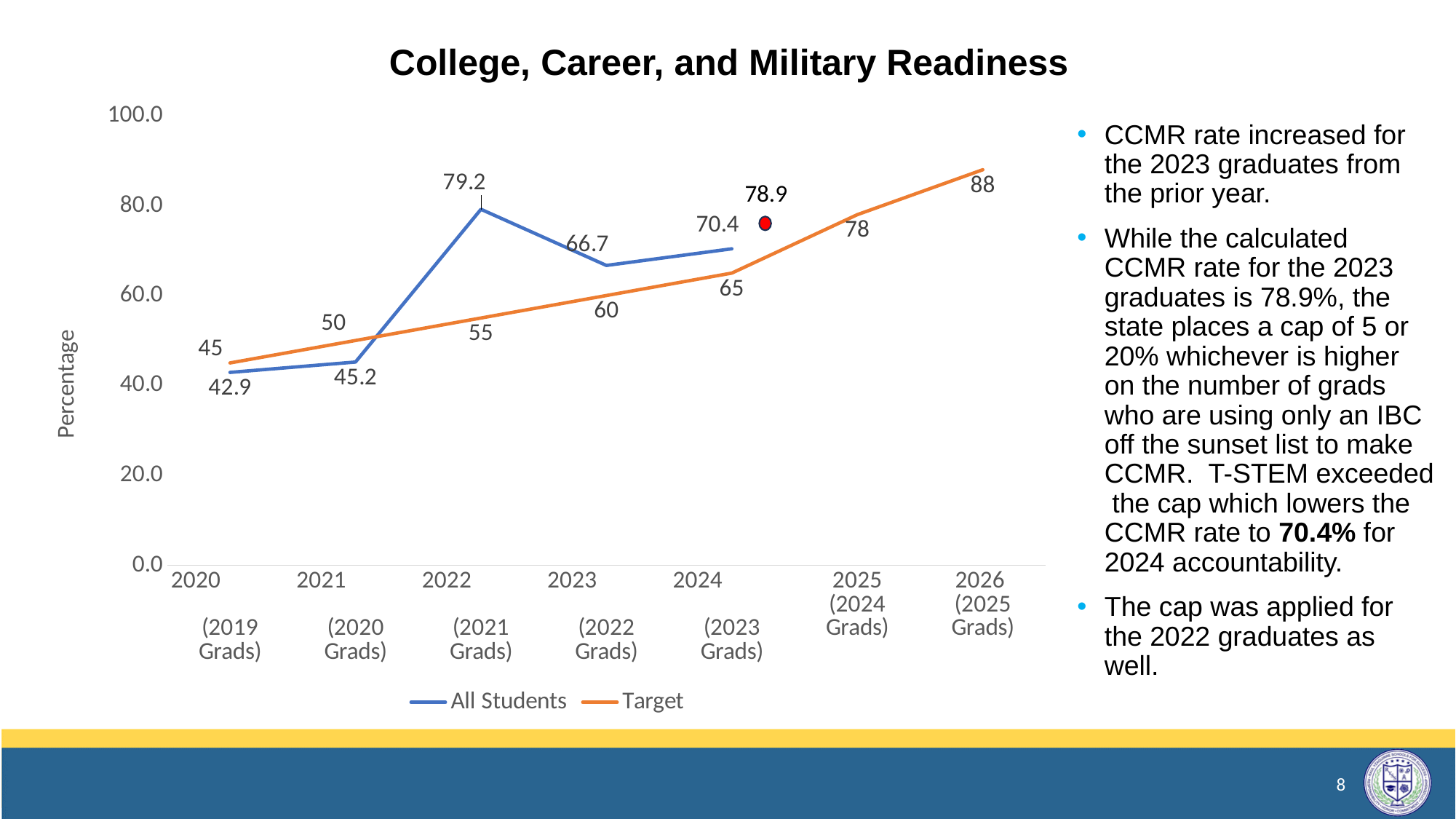
Which is larger for 2021 (2020 Grads): the All Students value or the Target value? Target What is the Target value for 2023 (2022 Grads)? 60 What is the All Students value for 2024 (2023 Grads)? 70.4 What type of chart is shown on the slide? line chart In which year is the All Students value lowest? 2020 How many years are shown on the x axis? 7 What is the difference between the All Students value and the Target value for 2022 (2021 Grads)? 24.2 In which year is the All Students value highest? 2022 What is the Target value for 2026 (2025 Grads)? 88 How many series does the legend list? 2 What is the All Students value for 2022 (2021 Grads)? 79.2 Does the Target series rise or fall from 2020 to 2026? rise